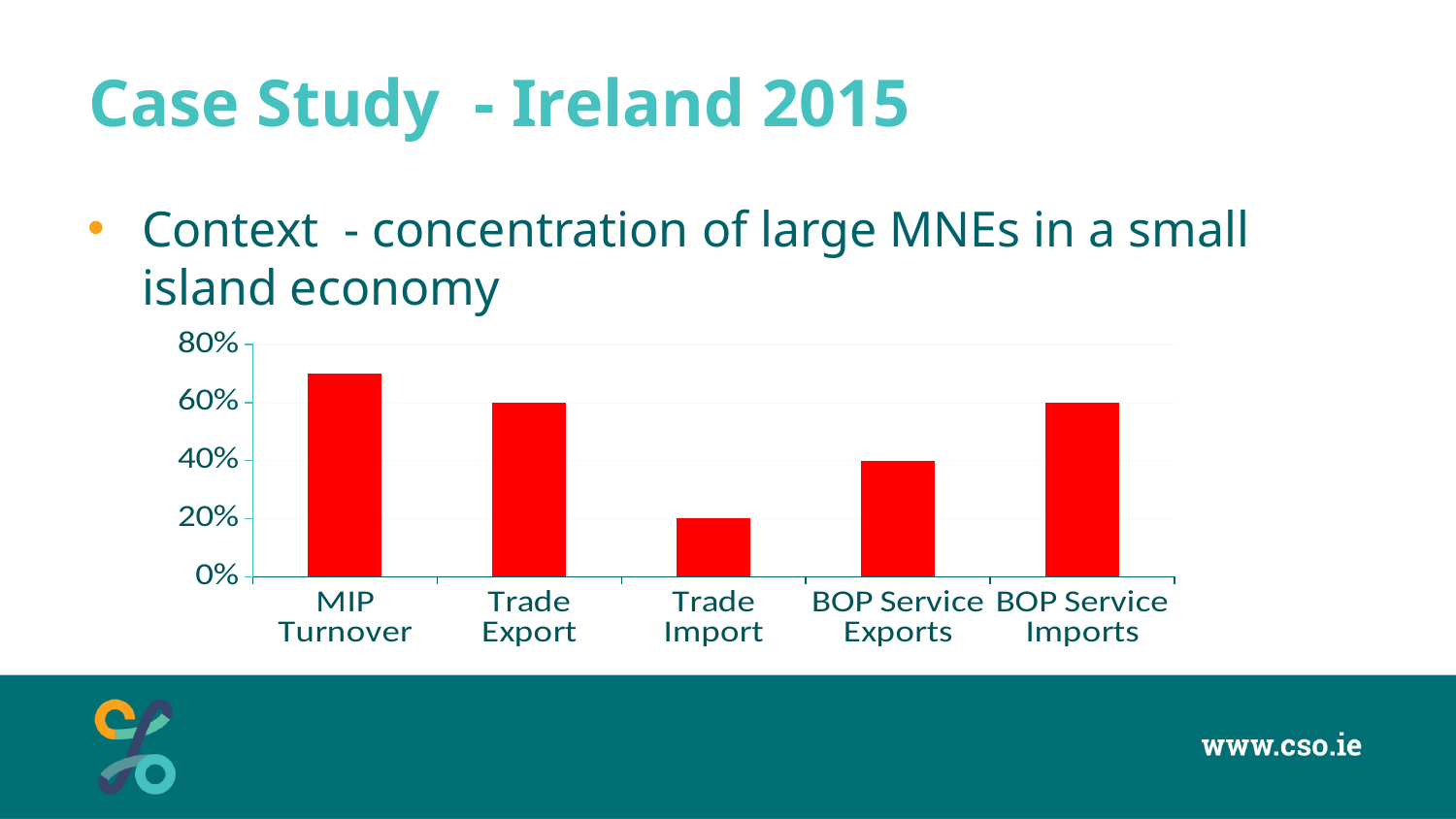
Which category has the highest value in the chart? MIP Turnover Is the value for MIP Turnover greater or less than 60%? greater What kind of chart is shown on the slide? bar chart Which is larger, the value for Trade Export or the value for BOP Service Exports? Trade Export How many categories are shown on the x axis of the chart? 5 What colour are the bars in the chart? red Which is larger, the value for MIP Turnover or the value for BOP Service Imports? MIP Turnover What is the difference between the value for Trade Export and the value for Trade Import? 40% What is the value for Trade Import? 20% What is the value for Trade Export? 60% Which category has the lowest value in the chart? Trade Import What is the value for BOP Service Exports? 40%